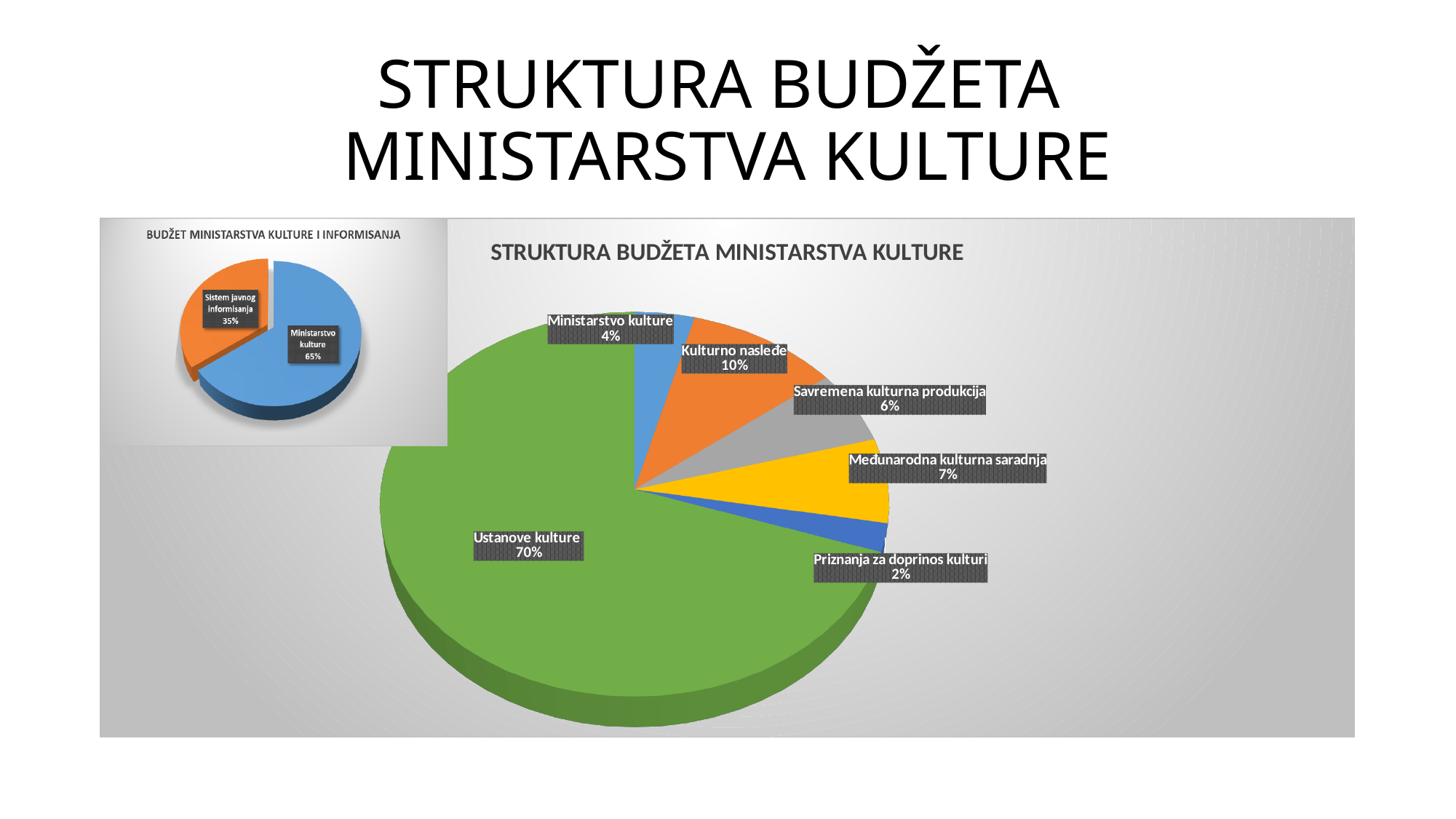
What kind of chart is the chart titled STRUKTURA BUDŽETA MINISTARSTVA KULTURE? Pie chart In the chart titled STRUKTURA BUDŽETA MINISTARSTVA KULTURE, which is larger: Međunarodna kulturna saradnja or Ministarstvo kulture? Međunarodna kulturna saradnja In the chart titled STRUKTURA BUDŽETA MINISTARSTVA KULTURE, what share does Kulturno nasleđe have? 10% In the chart titled STRUKTURA BUDŽETA MINISTARSTVA KULTURE, what is the difference between the shares of Kulturno nasleđe and Savremena kulturna produkcija? 4% In the chart titled STRUKTURA BUDŽETA MINISTARSTVA KULTURE, which category has the largest share? Ustanove kulture In the chart titled STRUKTURA BUDŽETA MINISTARSTVA KULTURE, what share does Ustanove kulture have? 70% In the chart titled BUDŽET MINISTARSTVA KULTURE I INFORMISANJA, what share does Sistem javnog informisanja have? 35% In the chart titled BUDŽET MINISTARSTVA KULTURE I INFORMISANJA, what is the difference between the shares of Ministarstvo kulture and Sistem javnog informisanja? 30% How many categories are shown in the chart titled STRUKTURA BUDŽETA MINISTARSTVA KULTURE? 6 In the chart titled STRUKTURA BUDŽETA MINISTARSTVA KULTURE, which category has the smallest share? Priznanja za doprinos kulturi In the chart titled BUDŽET MINISTARSTVA KULTURE I INFORMISANJA, which category has the larger share? Ministarstvo kulture In the chart titled STRUKTURA BUDŽETA MINISTARSTVA KULTURE, what share does Međunarodna kulturna saradnja have? 7%